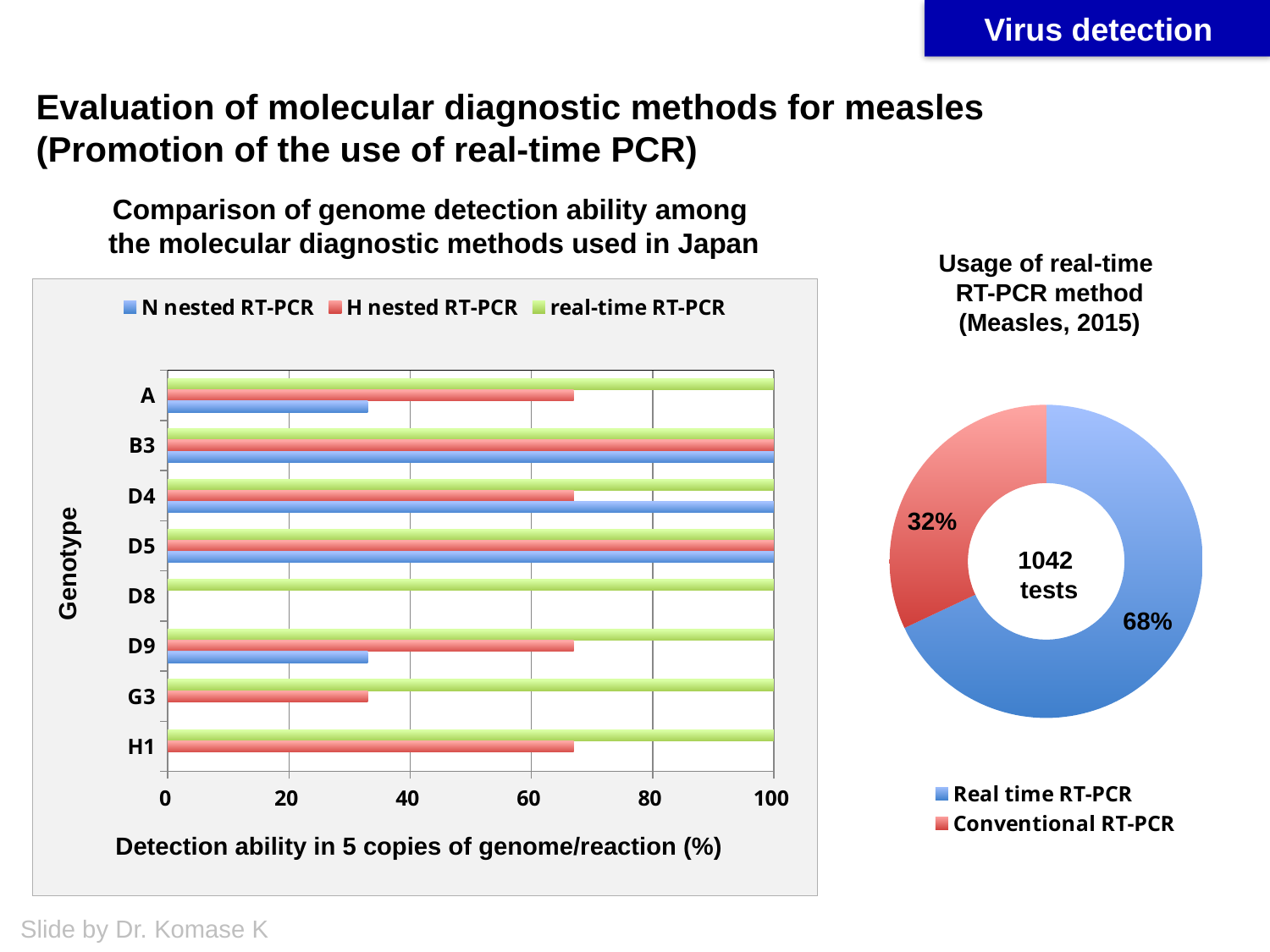
How many genotypes are shown on the y axis of the 'Comparison of genome detection ability' bar chart? 8 In the 'Usage of real-time RT-PCR method (Measles, 2015)' doughnut chart, how many tests are shown in the centre? 1042 tests In the 'Comparison of genome detection ability' bar chart, is the value for N nested RT-PCR for genotype A greater or less than 40? less In the 'Comparison of genome detection ability' bar chart, which is larger for genotype D9: the H nested RT-PCR value or the N nested RT-PCR value? H nested RT-PCR In the 'Comparison of genome detection ability' bar chart, what is the detection ability of real-time RT-PCR for genotype B3? 100 In the 'Comparison of genome detection ability' bar chart, what is the detection ability of N nested RT-PCR for genotype D5? 100 In the 'Usage of real-time RT-PCR method (Measles, 2015)' doughnut chart, what is the difference between the Real time RT-PCR share and the Conventional RT-PCR share? 36% What kind of chart is the 'Comparison of genome detection ability' chart on the left? bar chart In the 'Comparison of genome detection ability' bar chart, is the value for H nested RT-PCR for genotype H1 greater or less than 60? greater In the 'Comparison of genome detection ability' bar chart, what is the label on the x axis? Detection ability in 5 copies of genome/reaction (%) In the 'Usage of real-time RT-PCR method (Measles, 2015)' doughnut chart, what share is Real time RT-PCR? 68% How many series does the legend of the 'Comparison of genome detection ability' bar chart list? 3